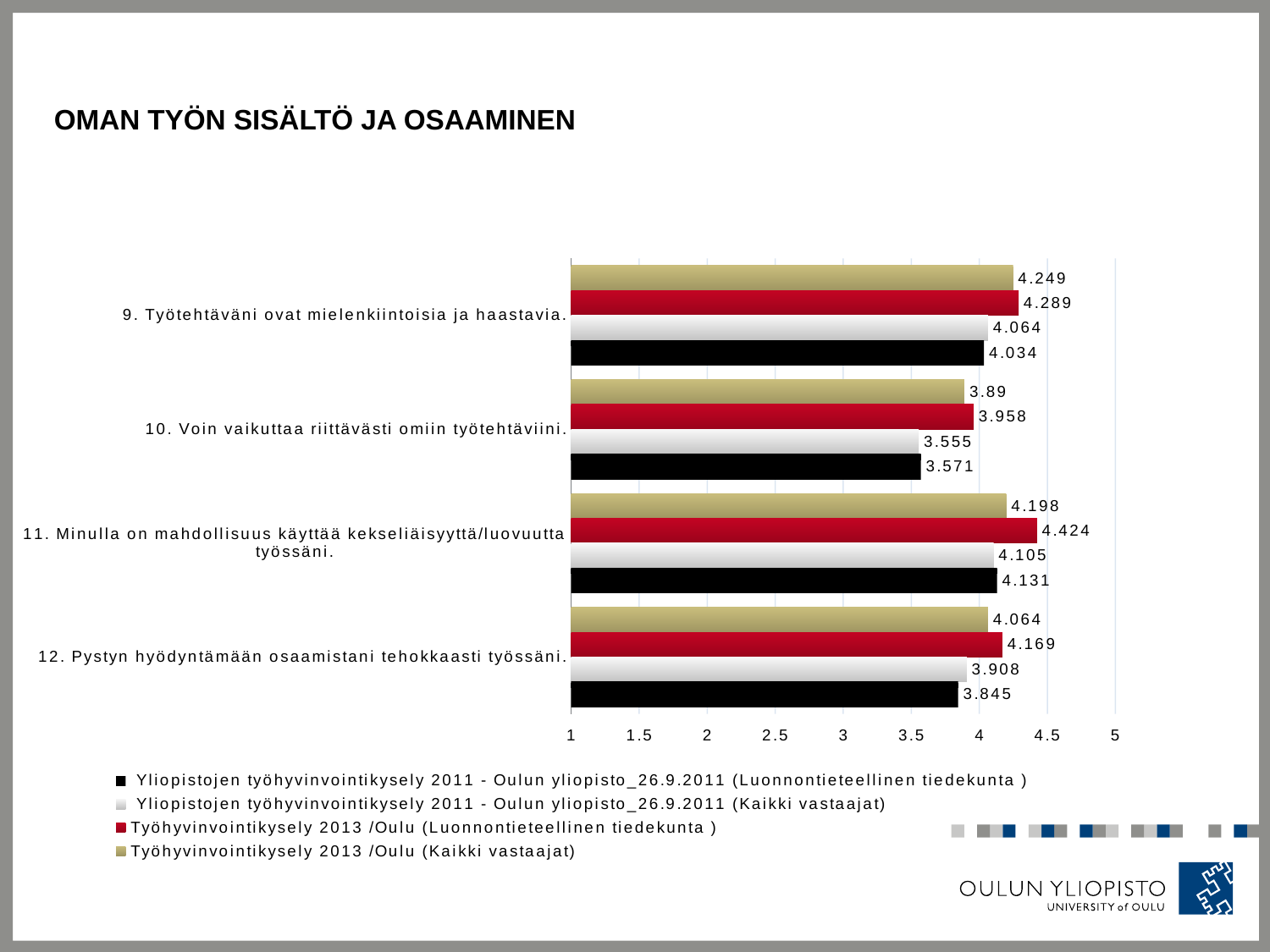
For '11. Minulla on mahdollisuus käyttää kekseliäisyyttä/luovuutta työssäni.', which is larger: the 'Työhyvinvointikysely 2013 /Oulu (Luonnontieteellinen tiedekunta )' value or the 'Työhyvinvointikysely 2013 /Oulu (Kaikki vastaajat)' value? Työhyvinvointikysely 2013 /Oulu (Luonnontieteellinen tiedekunta ) What is the difference between the 2013 and 2011 Luonnontieteellinen tiedekunta values for '10. Voin vaikuttaa riittävästi omiin työtehtäviini.'? 0.387 How many series does the legend list? 4 Which statement has the lowest value in the series 'Yliopistojen työhyvinvointikysely 2011 - Oulun yliopisto_26.9.2011 (Luonnontieteellinen tiedekunta )'? 10. Voin vaikuttaa riittävästi omiin työtehtäviini. What is the value for '9. Työtehtäväni ovat mielenkiintoisia ja haastavia.' in the series 'Työhyvinvointikysely 2013 /Oulu (Luonnontieteellinen tiedekunta )'? 4.289 What type of chart is shown on the slide? bar chart What is the value for '10. Voin vaikuttaa riittävästi omiin työtehtäviini.' in the series 'Yliopistojen työhyvinvointikysely 2011 - Oulun yliopisto_26.9.2011 (Kaikki vastaajat)'? 3.555 How many categories (statements) are shown on the chart? 4 What is the value for '12. Pystyn hyödyntämään osaamistani tehokkaasti työssäni.' in the series 'Työhyvinvointikysely 2013 /Oulu (Kaikki vastaajat)'? 4.064 What is the title of the slide containing the chart? OMAN TYÖN SISÄLTÖ JA OSAAMINEN Is the value for '12. Pystyn hyödyntämään osaamistani tehokkaasti työssäni.' in the series 'Yliopistojen työhyvinvointikysely 2011 - Oulun yliopisto_26.9.2011 (Luonnontieteellinen tiedekunta )' greater or less than 4? less Which statement has the highest value in the series 'Työhyvinvointikysely 2013 /Oulu (Luonnontieteellinen tiedekunta )'? 11. Minulla on mahdollisuus käyttää kekseliäisyyttä/luovuutta työssäni.